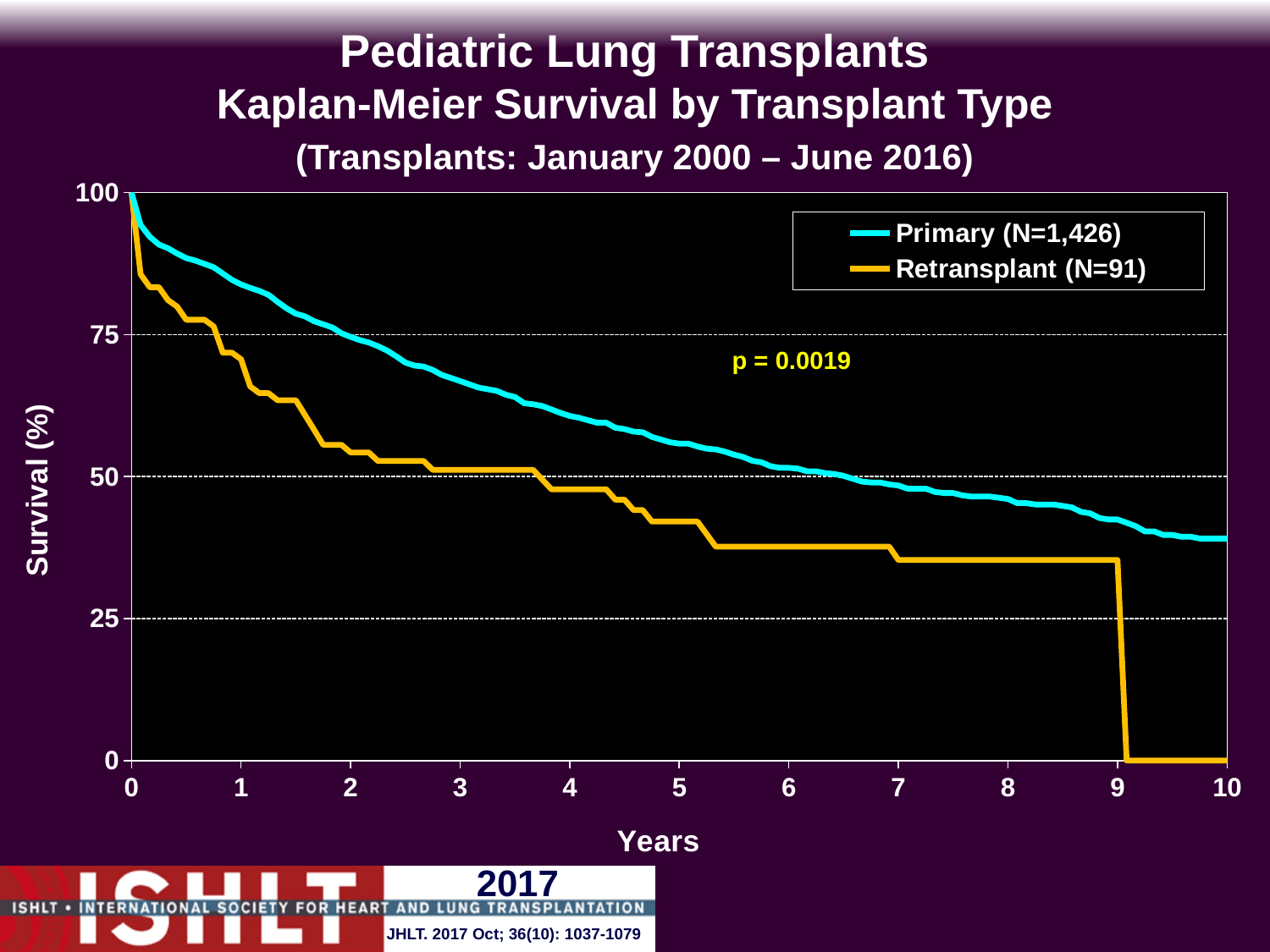
Do the survival curves rise or fall as years increase along the x axis? Fall Is the Primary survival at 10 years greater or less than 50? less What kind of chart is shown on the slide? Line chart Is the Retransplant survival at 5 years greater or less than 50? less What is the number of patients (N) in the Retransplant group? 91 How many series does the legend list? 2 Is the Primary survival at 1 year greater or less than 75? greater What p-value is printed on the chart? p = 0.0019 At 5 years, which series has the higher survival, Primary or Retransplant? Primary What is the number of patients (N) in the Primary group? 1,426 What colour is the line for the Retransplant series? Orange